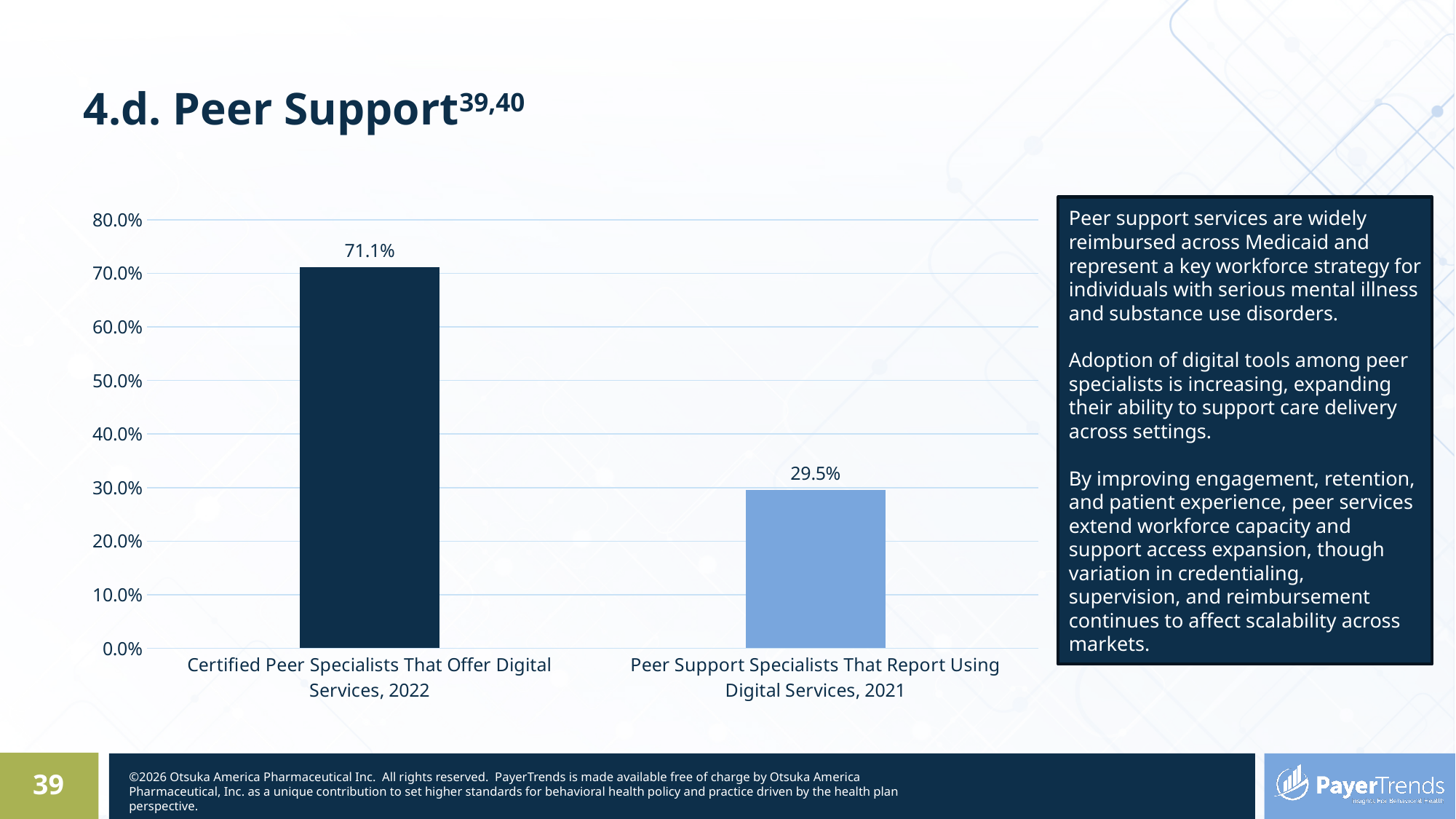
How many categories are shown in the chart? 2 What kind of chart is shown on the slide? Bar chart Which category has the highest value? Certified Peer Specialists That Offer Digital Services, 2022 Which is larger: the value for Certified Peer Specialists That Offer Digital Services, 2022 or the value for Peer Support Specialists That Report Using Digital Services, 2021? Certified Peer Specialists That Offer Digital Services, 2022 What is the highest value shown on the y axis? 80.0% Is the value for Peer Support Specialists That Report Using Digital Services, 2021 greater or less than 30.0%? less What is the value for Certified Peer Specialists That Offer Digital Services, 2022? 71.1% Which category has the lowest value? Peer Support Specialists That Report Using Digital Services, 2021 What is the value for Peer Support Specialists That Report Using Digital Services, 2021? 29.5% What is the difference between the value for Certified Peer Specialists That Offer Digital Services, 2022 and the value for Peer Support Specialists That Report Using Digital Services, 2021? 41.6% What is the title of the slide? 4.d. Peer Support Is the value for Certified Peer Specialists That Offer Digital Services, 2022 greater or less than 70.0%? greater